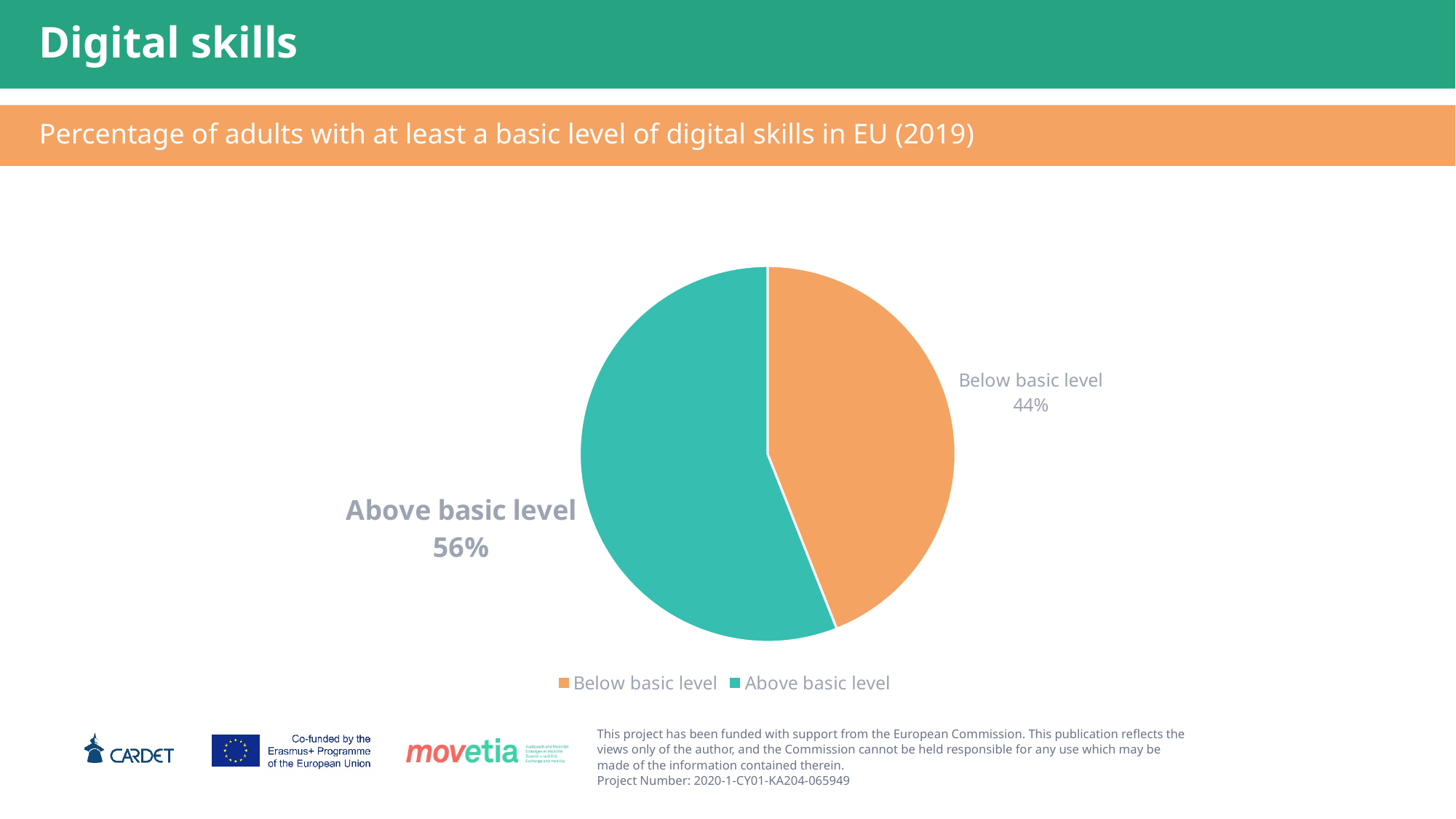
How many slices does the pie chart have? 2 What colour is the 'Above basic level' slice? Teal What percentage of adults are at the 'Below basic level' of digital skills? 44% What is the difference in percentage points between 'Above basic level' and 'Below basic level'? 12 What type of chart is shown on the slide? Pie chart Is the share for 'Above basic level' larger or smaller than the share for 'Below basic level'? Larger What is the subtitle describing the chart on the slide? Percentage of adults with at least a basic level of digital skills in EU (2019) What share of the pie does the 'Below basic level' slice represent? 44% What percentage of adults are at the 'Above basic level' of digital skills? 56% Which category has the smaller share of the pie? Below basic level Which category has the larger share of the pie? Above basic level How many entries does the legend list? 2